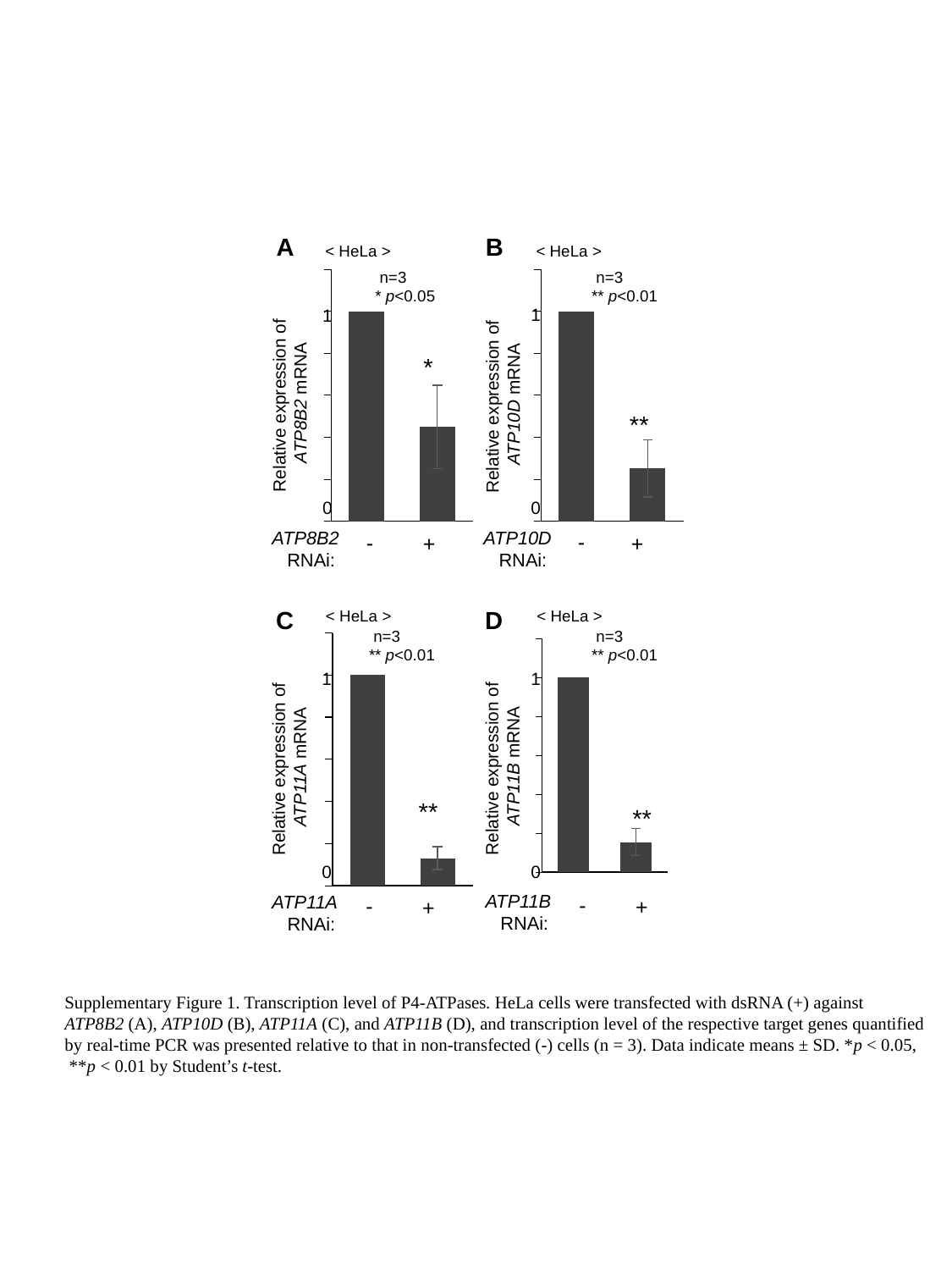
In chart D (ATP11B RNAi), what is the relative expression value for the - condition? 1 In chart B (ATP10D RNAi), is the value for the + condition greater or less than 1? less How many bars are plotted in chart C (ATP11A RNAi)? 2 In chart B (ATP10D RNAi), which condition has the higher relative expression, - or +? - In chart A (ATP8B2 RNAi), is the value for the + condition greater or less than 1? less In chart D (ATP11B RNAi), which condition has the highest relative expression? - What p-value threshold is annotated on chart B (ATP10D)? ** p<0.01 In chart A (ATP8B2 RNAi), what is the relative expression value for the - condition? 1 In chart D (ATP11B RNAi), is the value for the + condition greater or less than 1? less What sample size (n) is annotated on chart A (ATP8B2)? n=3 In chart C (ATP11A RNAi), which condition has the lowest relative expression? + What kind of chart is chart A (ATP8B2)? bar chart